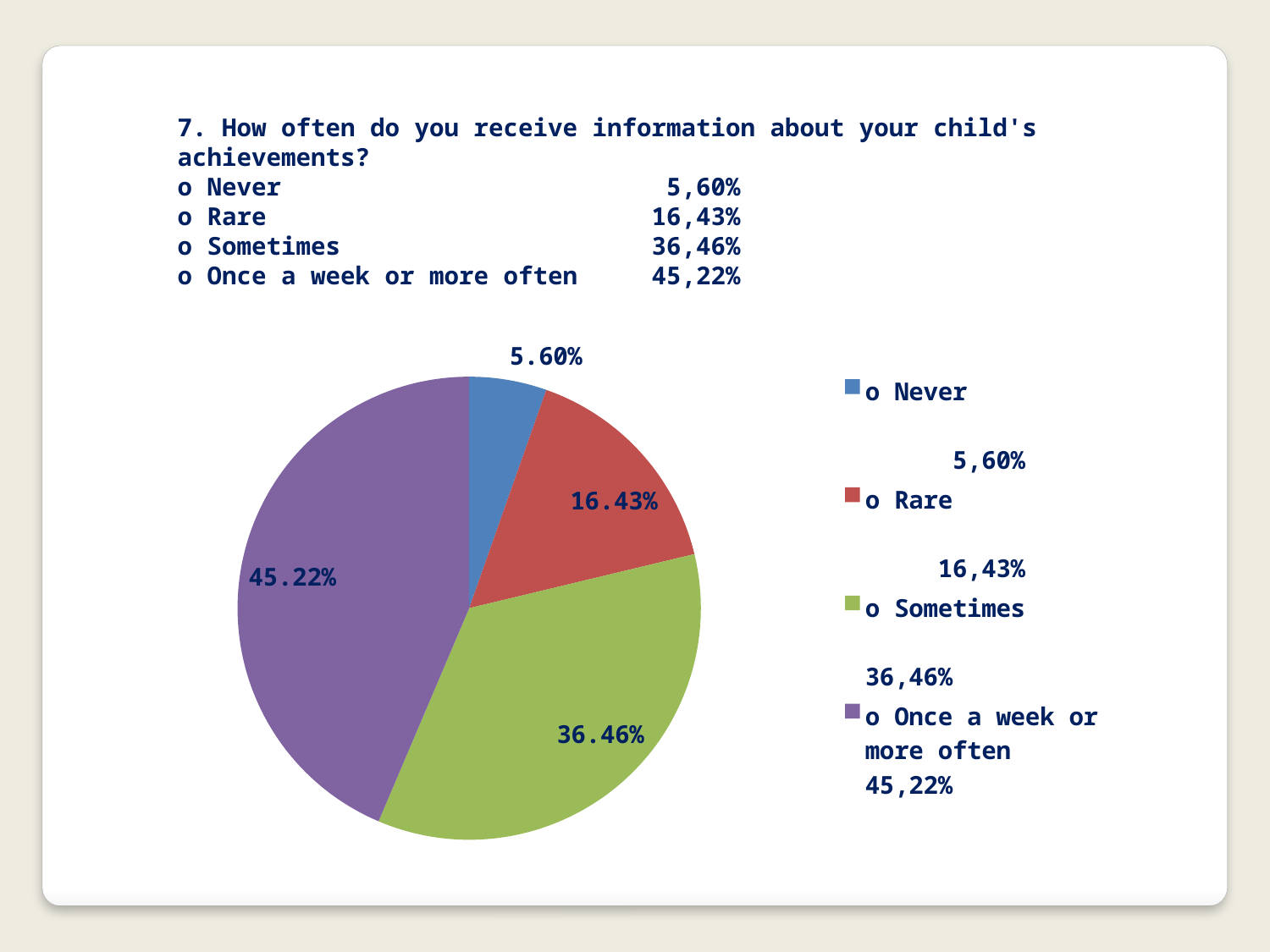
What is the value shown for the "Sometimes" slice? 36.46% How many slices does the pie chart have? 4 Which is larger, the "Sometimes" slice or the "Rare" slice? Sometimes Which category has the smallest slice of the pie? Never What is the difference between the "Once a week or more often" slice and the "Sometimes" slice? 8.76% What kind of chart is shown on the slide? pie chart What is the value shown for the "Rare" slice? 16.43% What share of the pie does the "Never" slice represent? 5.60% Which category has the largest slice of the pie? Once a week or more often What is the value shown for the "Once a week or more often" slice? 45.22% What is the difference between the "Rare" slice and the "Never" slice? 10.83% What colour is the "Sometimes" slice in the pie chart? green